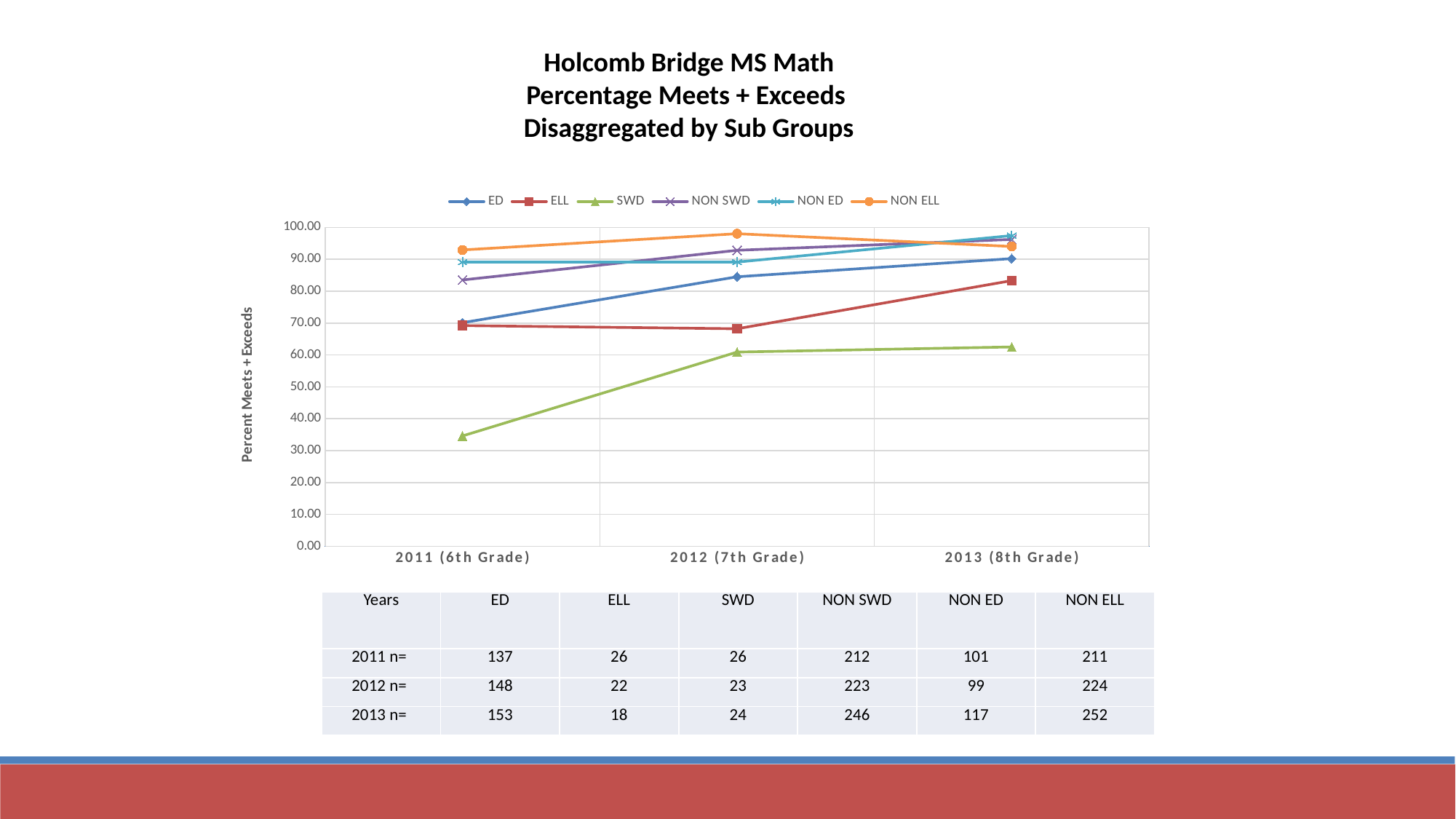
Is the value for ELL in 2013 (8th Grade) greater or less than 80.00? greater Is the value for NON ELL in 2012 (7th Grade) greater or less than 90.00? greater What kind of chart is shown on the slide? line chart How many series does the chart legend list? 6 How many points are there along the x axis of the chart? 3 Is the value for SWD in 2011 (6th Grade) greater or less than 40.00? less Which sub group has the highest value in 2012 (7th Grade)? NON ELL Does the SWD line rise or fall from 2011 (6th Grade) to 2013 (8th Grade)? rise In 2012 (7th Grade), which is higher: ED or ELL? ED What is the title of the y axis of the chart? Percent Meets + Exceeds Which sub group has the lowest value in 2011 (6th Grade)? SWD Does the NON ELL line rise or fall from 2012 (7th Grade) to 2013 (8th Grade)? fall